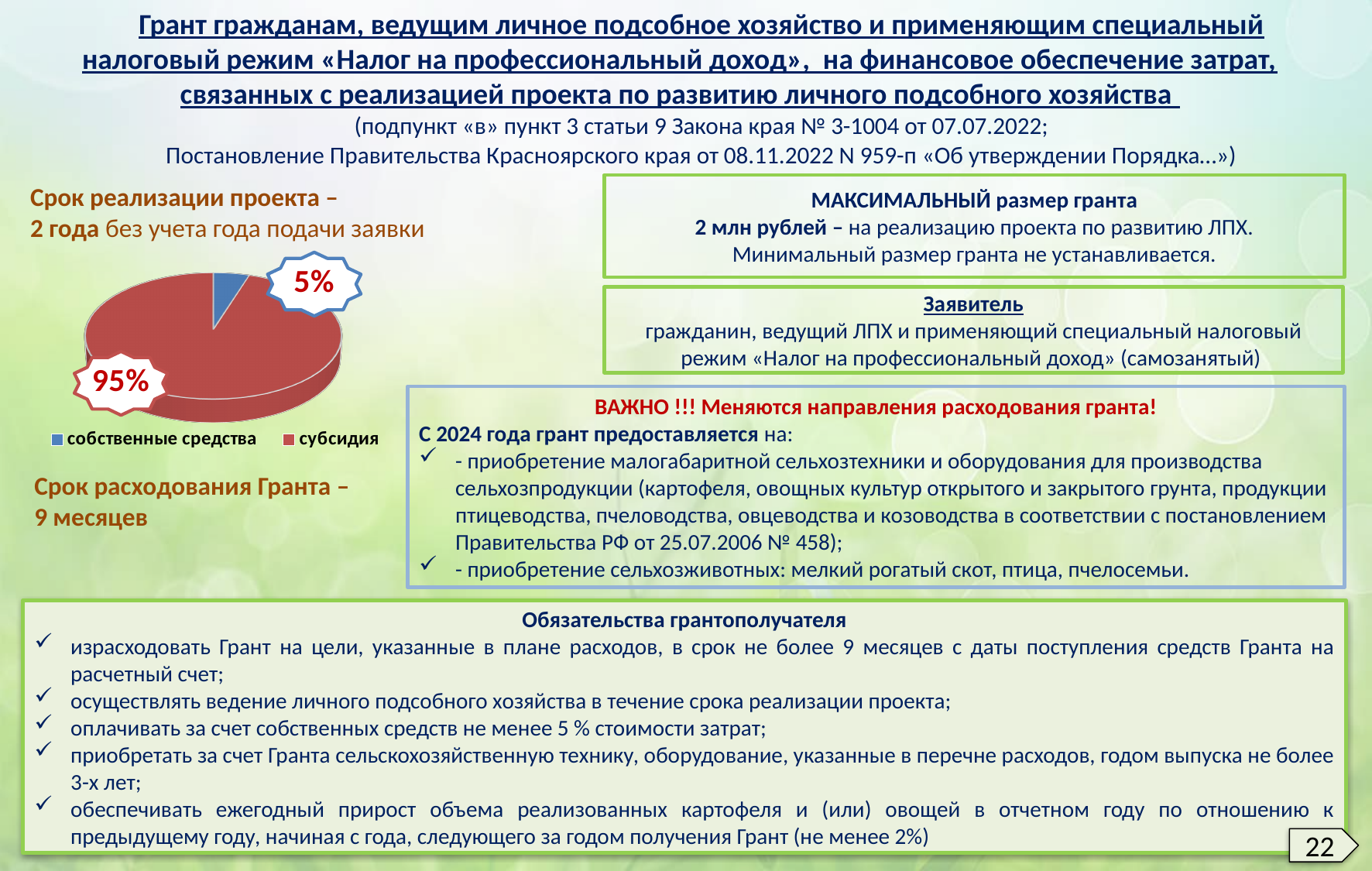
What share of the pie does "собственные средства" represent? 5% Which slice of the pie is the largest? субсидия What kind of chart is shown on the slide? pie chart How many entries does the legend of the pie chart list? 2 What colour is the "собственные средства" slice in the pie chart? blue Which is larger: the "субсидия" slice or the "собственные средства" slice? субсидия What share of the pie does "субсидия" represent? 95% What colour is the "субсидия" slice in the pie chart? red Which slice of the pie is the smallest? собственные средства How many slices does the pie chart have? 2 What is the difference in percentage points between the "субсидия" and "собственные средства" slices? 90